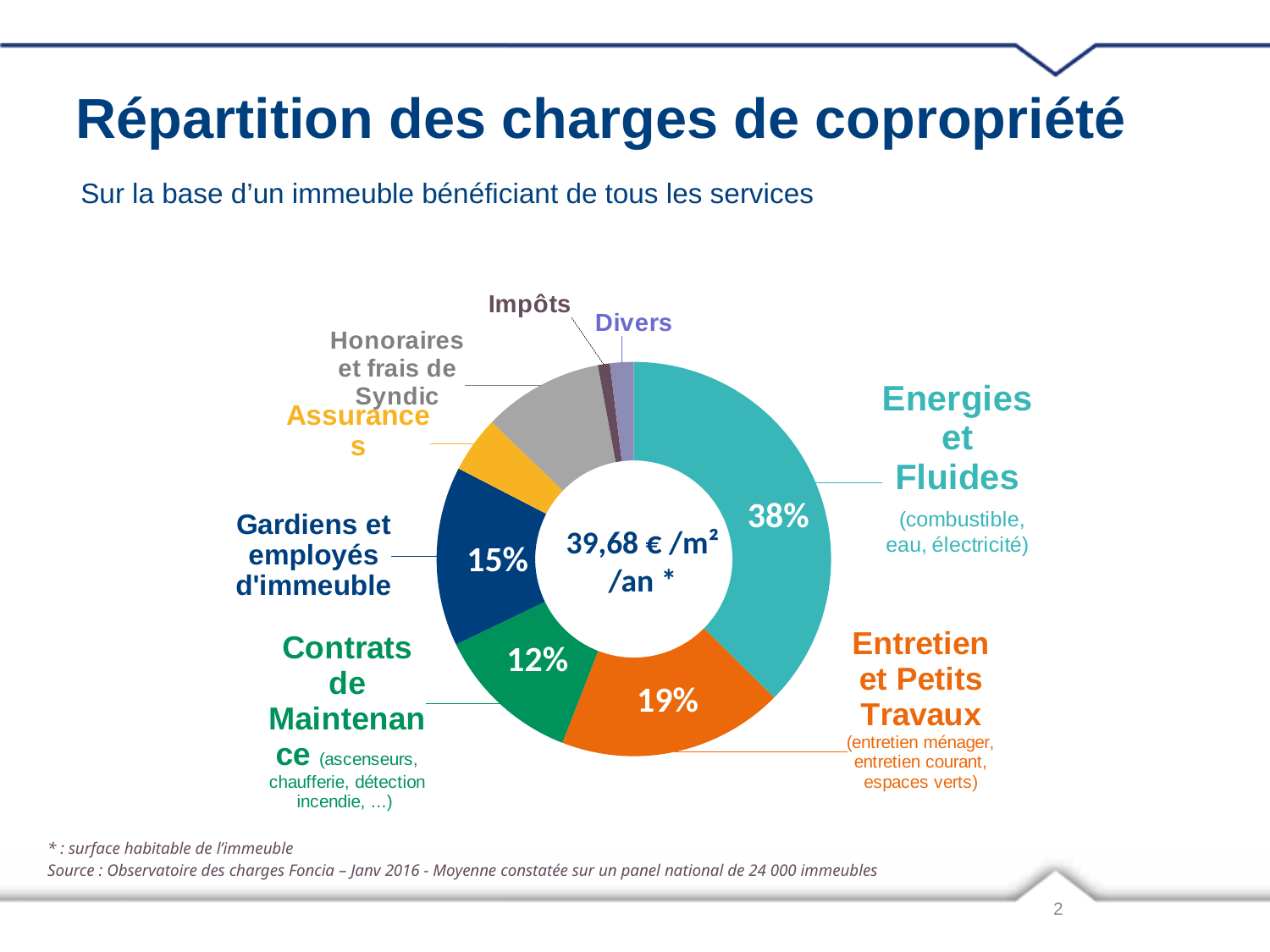
What kind of chart is shown on the slide? Pie chart (donut) What share of the charges is Energies et Fluides? 38% What share of the charges is Gardiens et employés d'immeuble? 15% What is the combined share of Gardiens et employés d'immeuble and Contrats de Maintenance? 27% What share of the charges is Entretien et Petits Travaux? 19% Which category has the largest share of the charges? Energies et Fluides What is the difference in percentage points between Energies et Fluides and Entretien et Petits Travaux? 19 percentage points What is the title of the slide containing the chart? Répartition des charges de copropriété What value is printed in the centre of the donut chart? 39,68 € /m² /an What share of the charges is Contrats de Maintenance? 12% How many categories does the chart show? 8 Which is larger: the share for Gardiens et employés d'immeuble or the share for Contrats de Maintenance? Gardiens et employés d'immeuble